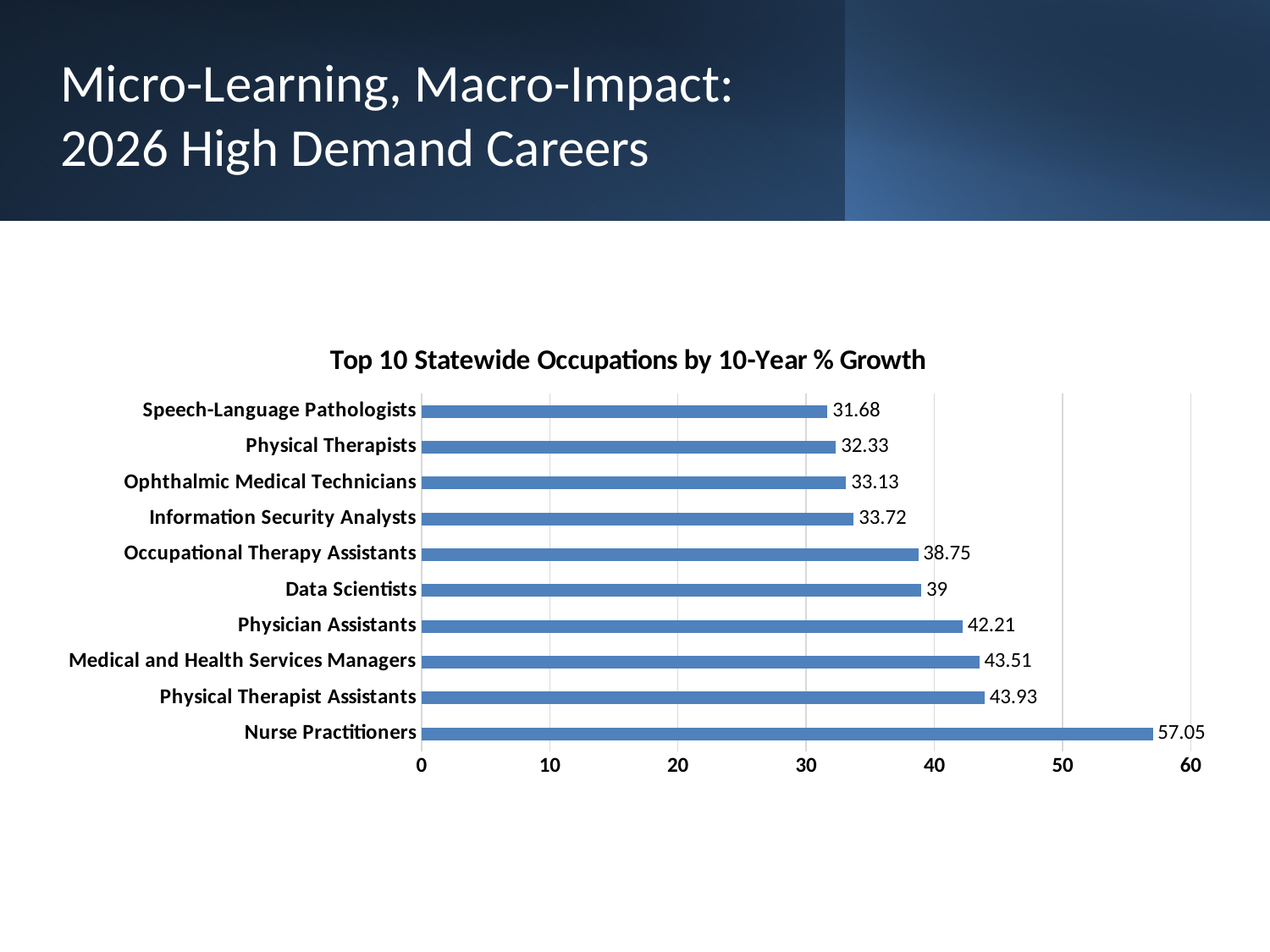
What is the title of the chart? Top 10 Statewide Occupations by 10-Year % Growth Which has a larger value, Physician Assistants or Occupational Therapy Assistants? Physician Assistants Which occupation has the highest 10-year % growth? Nurse Practitioners Is the value for Medical and Health Services Managers greater or less than 40? greater Which occupation has the lowest 10-year % growth? Speech-Language Pathologists What is the 10-year % growth value for Nurse Practitioners? 57.05 What is the value shown for Information Security Analysts? 33.72 How many occupations are shown in the chart? 10 What is the difference between the values for Nurse Practitioners and Physical Therapist Assistants? 13.12 What kind of chart is shown on the slide? Bar chart What is the maximum value shown on the horizontal axis? 60 What is the value shown for Data Scientists? 39